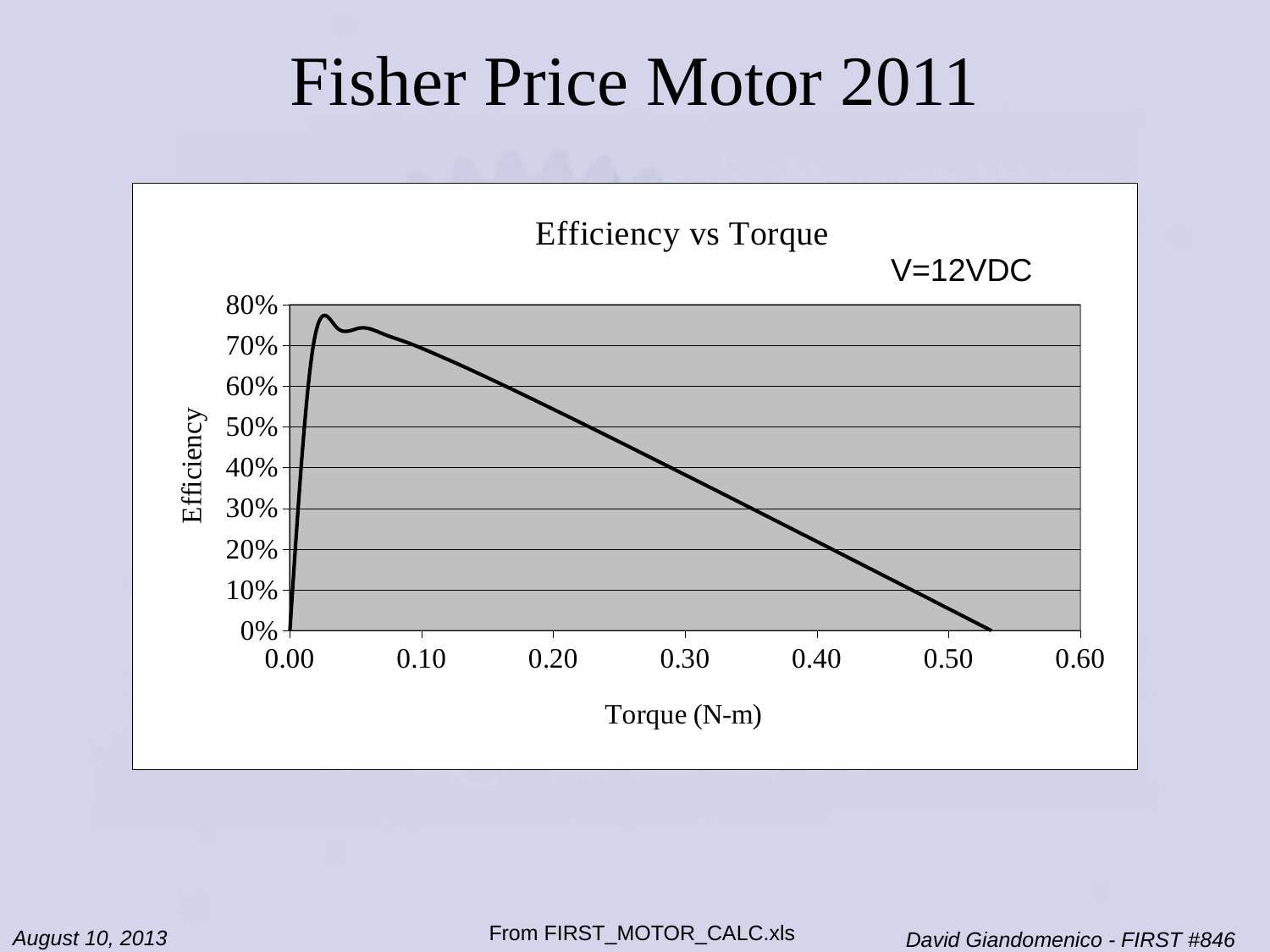
Is the efficiency at a torque of 0.50 N-m greater or less than 10%? less Is the peak efficiency shown on the chart greater or less than 80%? less Is the peak efficiency shown on the chart greater or less than 70%? greater What kind of chart is shown on the slide? line chart Which torque has the higher efficiency, 0.20 N-m or 0.40 N-m? 0.20 N-m After reaching its peak, does efficiency rise or fall as torque increases? fall What is the highest value shown on the efficiency axis? 80% What is the title of the chart? Efficiency vs Torque What is the label of the x axis of the chart? Torque (N-m)